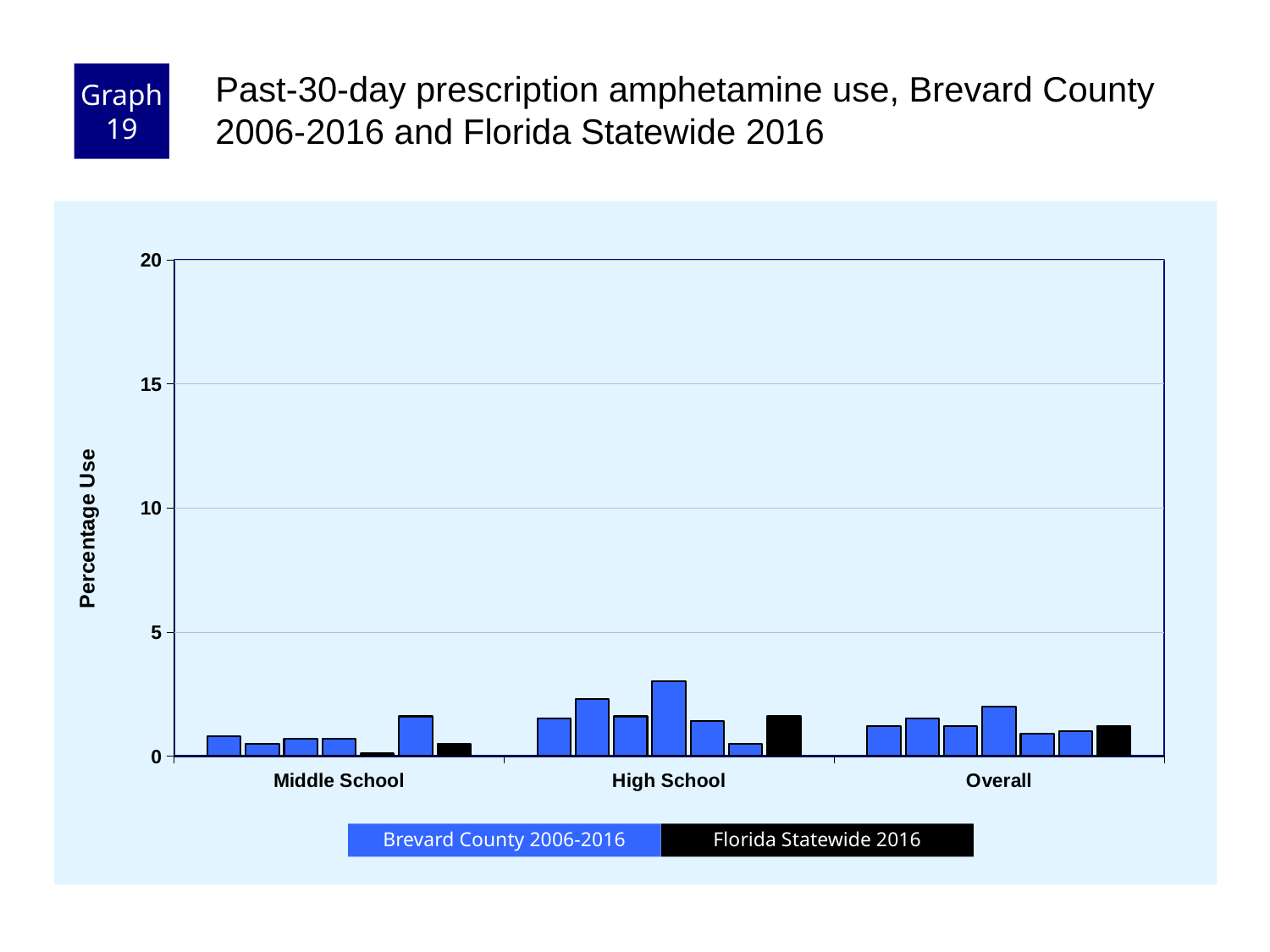
Is the Florida Statewide 2016 value for Overall greater or less than 5? less What kind of chart is shown on the slide? Bar chart Which is larger: the Florida Statewide 2016 value for High School or for Middle School? High School What is the label on the y axis? Percentage Use Which category group contains the tallest bar on the chart? High School Is the Florida Statewide 2016 value for High School greater or less than 5? less Which is larger: the Florida Statewide 2016 value for Overall or for Middle School? Overall Is the tallest Brevard County bar in the High School group greater or less than 5? less How many categories are shown on the x axis? 3 How many series does the legend list? 2 Which colour represents Florida Statewide 2016 in the legend? Black